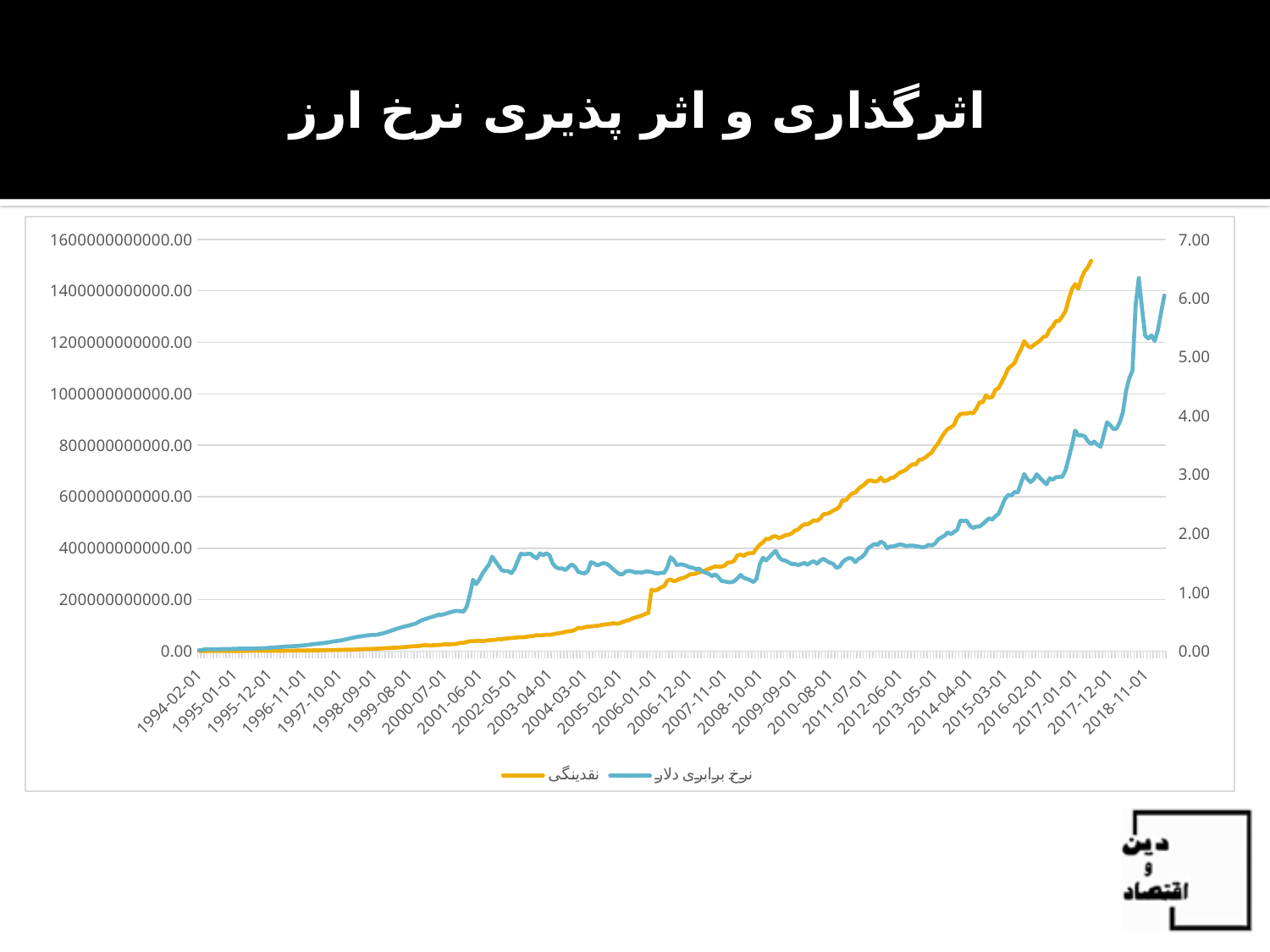
What kind of chart is shown on the slide? line chart Is the peak value of the نرخ برابری دلار series greater or less than 6.00 on the right axis? greater Is the final value of the نقدینگی series (at the right end of the chart) greater or less than 1400000000000.00 on the left axis? greater What is the highest tick value shown on the right-hand vertical axis? 7.00 How many series does the legend list? 2 What is the last date label on the x axis? 2018-11-01 Does the نقدینگی series generally rise or fall from left to right along the x axis? rise Is the value of the نرخ برابری دلار series at 2013-05-01 greater or less than 2.00 on the right axis? less Which series is drawn in yellow/orange? نقدینگی What is the highest tick value shown on the left-hand vertical axis? 1600000000000.00 What is the first date label on the x axis? 1994-02-01 Which series is drawn in blue? نرخ برابری دلار